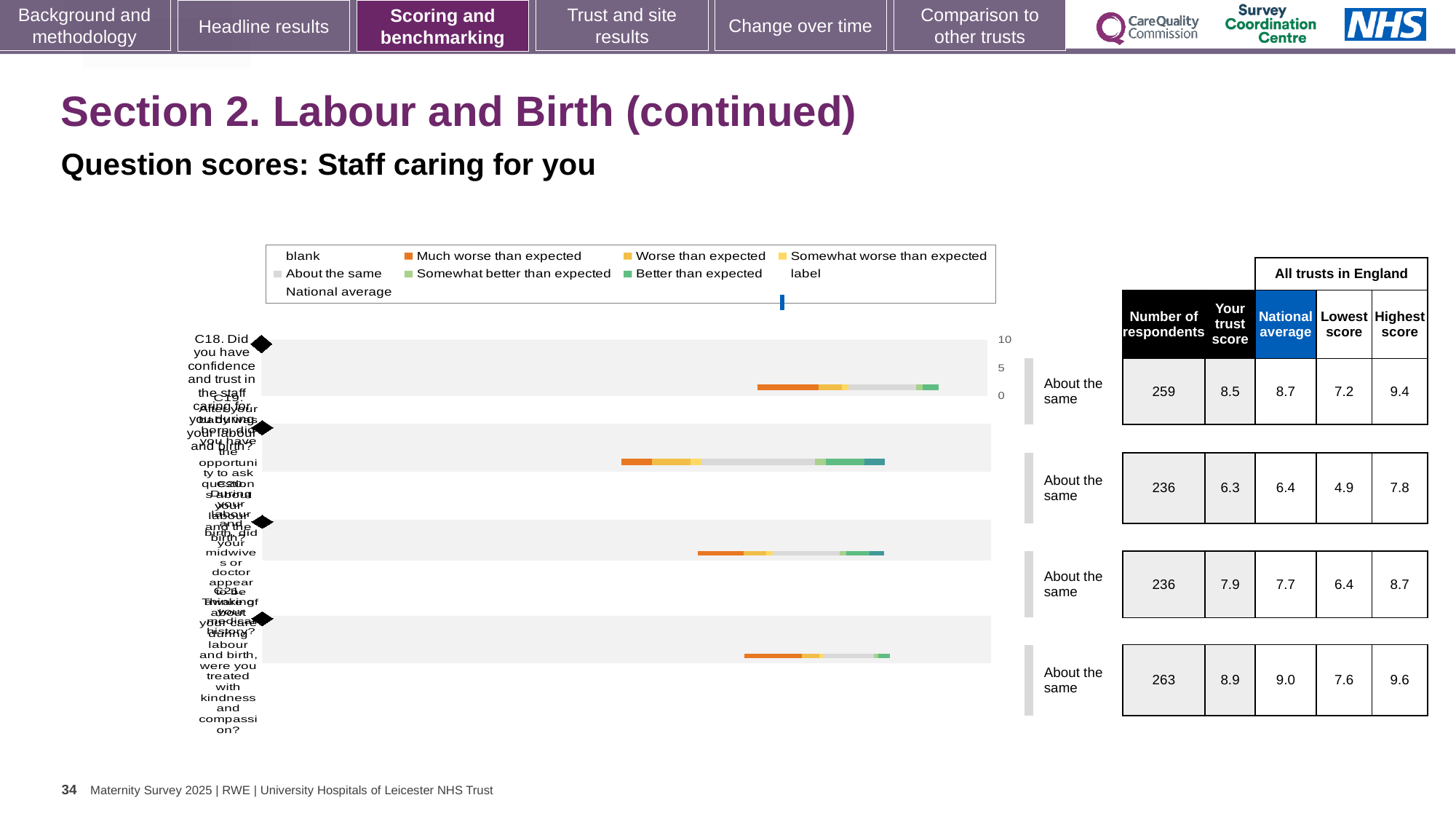
How many questions (categories) are plotted in the chart? 4 How many respondents answered question C21? 263 What is the national average score for question C19? 6.4 What is the difference between the national average and the trust score for question C18? 0.2 Which colour in the legend represents 'Much worse than expected'? orange What benchmark category is shown for all four questions on this slide? About the same What is the trust score for question C18 (confidence and trust in the staff caring for you)? 8.5 Which question has the lowest trust score? C19 For question C20, which is larger: the trust score or the national average? the trust score What is the highest score among all trusts in England for question C20? 8.7 What kind of chart is used to show the question scores on this slide? bar chart Which question has the highest trust score? C21